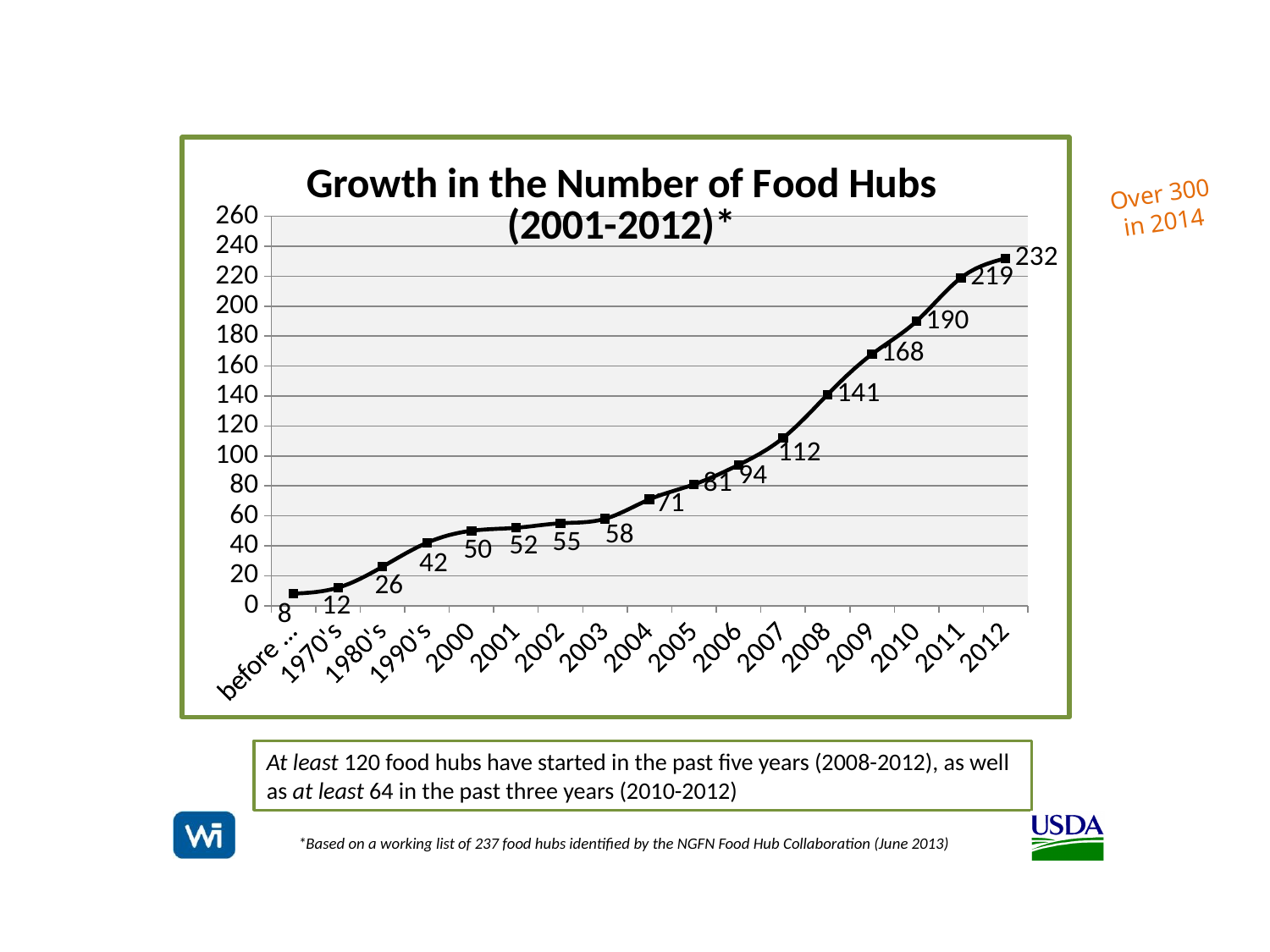
What is the number of food hubs for 2008? 141 What is the number of food hubs for 2004? 71 What is the number of food hubs for 2012? 232 What is the number of food hubs for the 1990's? 42 What kind of chart is shown on the slide? line chart Which category has the lowest value? before ... What is the title of the chart? Growth in the Number of Food Hubs (2001-2012)* Which category has the highest value? 2012 Which is larger, the value for 2007 or the value for 2006? 2007 What is the difference between the values for 2010 and 2009? 22 Do the values rise or fall from left to right along the x axis? rise What is the difference between the values for 2012 and 2011? 13